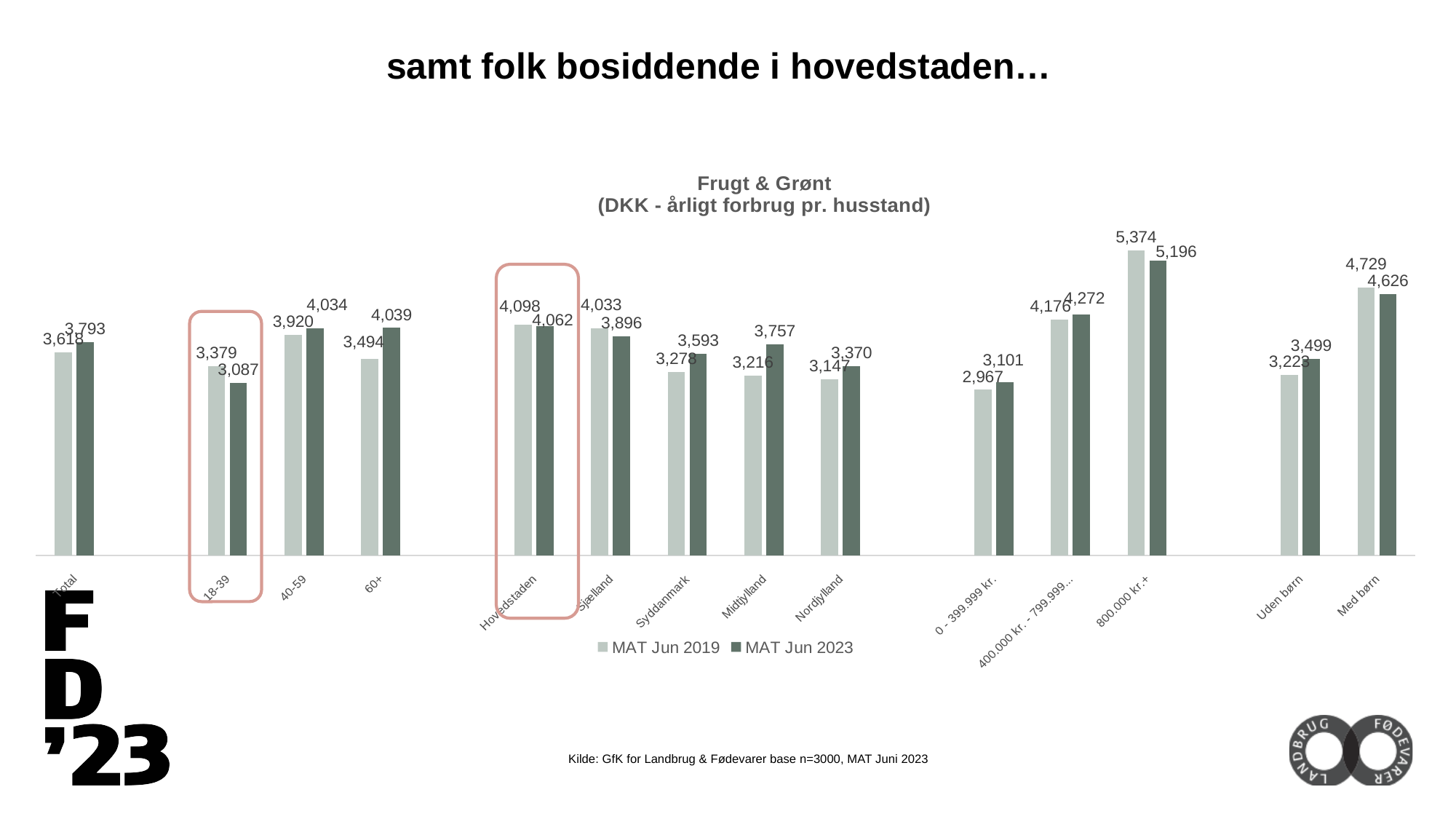
What is the MAT Jun 2023 value for Hovedstaden? 4,062 What is the difference between the MAT Jun 2019 and MAT Jun 2023 values for Total? 175 What kind of chart is shown on the slide? Bar chart What is the MAT Jun 2023 value for Midtjylland? 3,757 What is the title of the chart? Frugt & Grønt (DKK - årligt forbrug pr. husstand) Which category has the highest MAT Jun 2019 value? 800.000 kr.+ What is the MAT Jun 2019 value for 18-39? 3,379 How many categories are shown on the x axis? 14 How many series does the legend list? 2 Which category has the lowest MAT Jun 2023 value? 18-39 Which is larger for Sjælland: the MAT Jun 2019 value or the MAT Jun 2023 value? MAT Jun 2019 What is the difference between the MAT Jun 2019 and MAT Jun 2023 values for 60+? 545